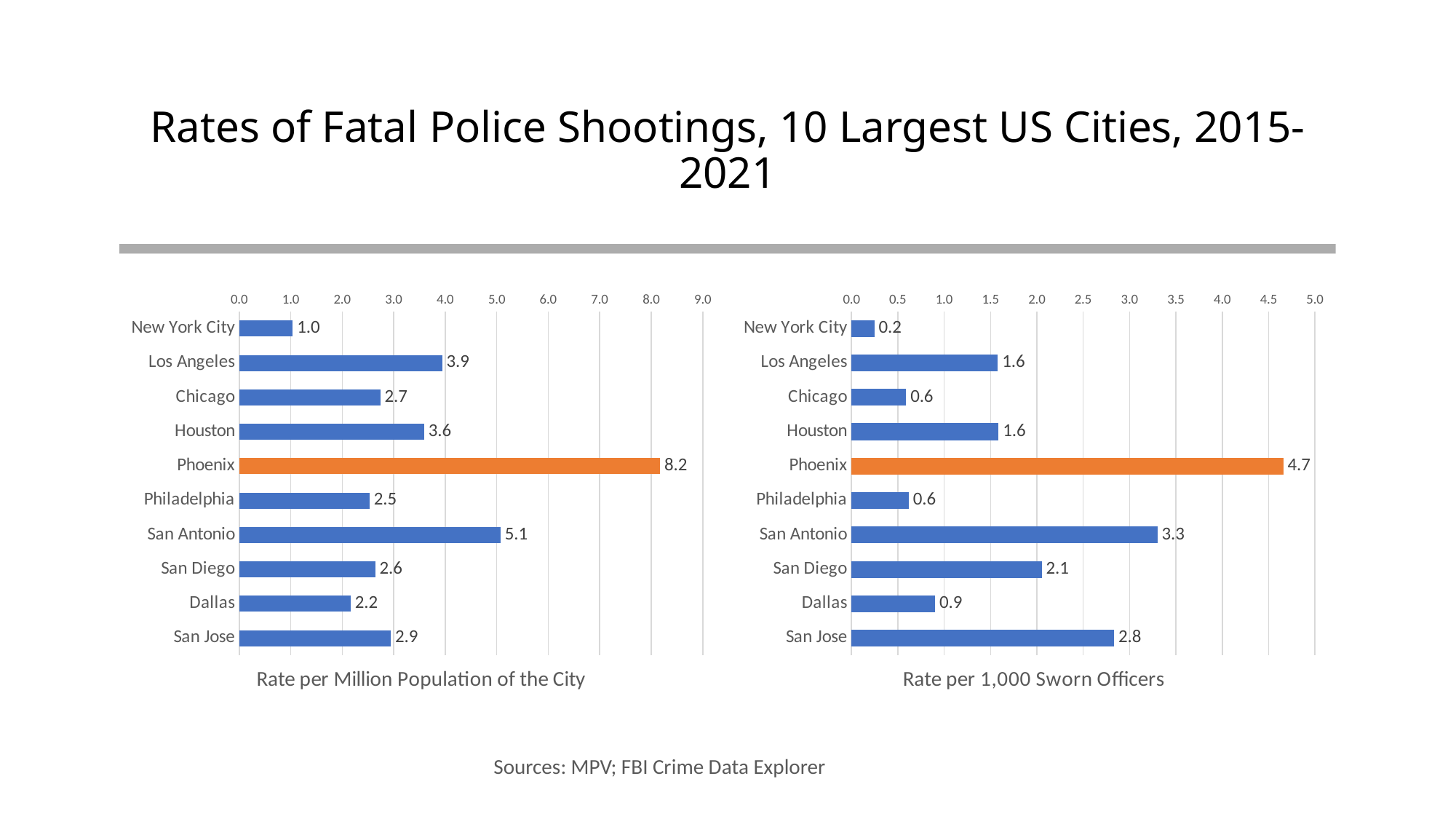
In the 'Rate per 1,000 Sworn Officers' chart, which is larger, San Diego or Dallas? San Diego In the 'Rate per Million Population of the City' chart, what is the value for Phoenix? 8.2 In the 'Rate per Million Population of the City' chart, which city has the lowest value? New York City In the 'Rate per 1,000 Sworn Officers' chart, which city's bar is highlighted in orange? Phoenix In the 'Rate per Million Population of the City' chart, which is larger, Los Angeles or Houston? Los Angeles In the 'Rate per 1,000 Sworn Officers' chart, what is the value for San Antonio? 3.3 In the 'Rate per 1,000 Sworn Officers' chart, which city has the highest value? Phoenix In the 'Rate per Million Population of the City' chart, is the value for San Jose greater or less than 2.0? greater In the 'Rate per Million Population of the City' chart, what is the difference between Phoenix and San Antonio? 3.1 What type of chart is the 'Rate per Million Population of the City' chart? Bar chart How many cities are shown in the 'Rate per 1,000 Sworn Officers' chart? 10 In the 'Rate per 1,000 Sworn Officers' chart, what is the difference between Phoenix and New York City? 4.5